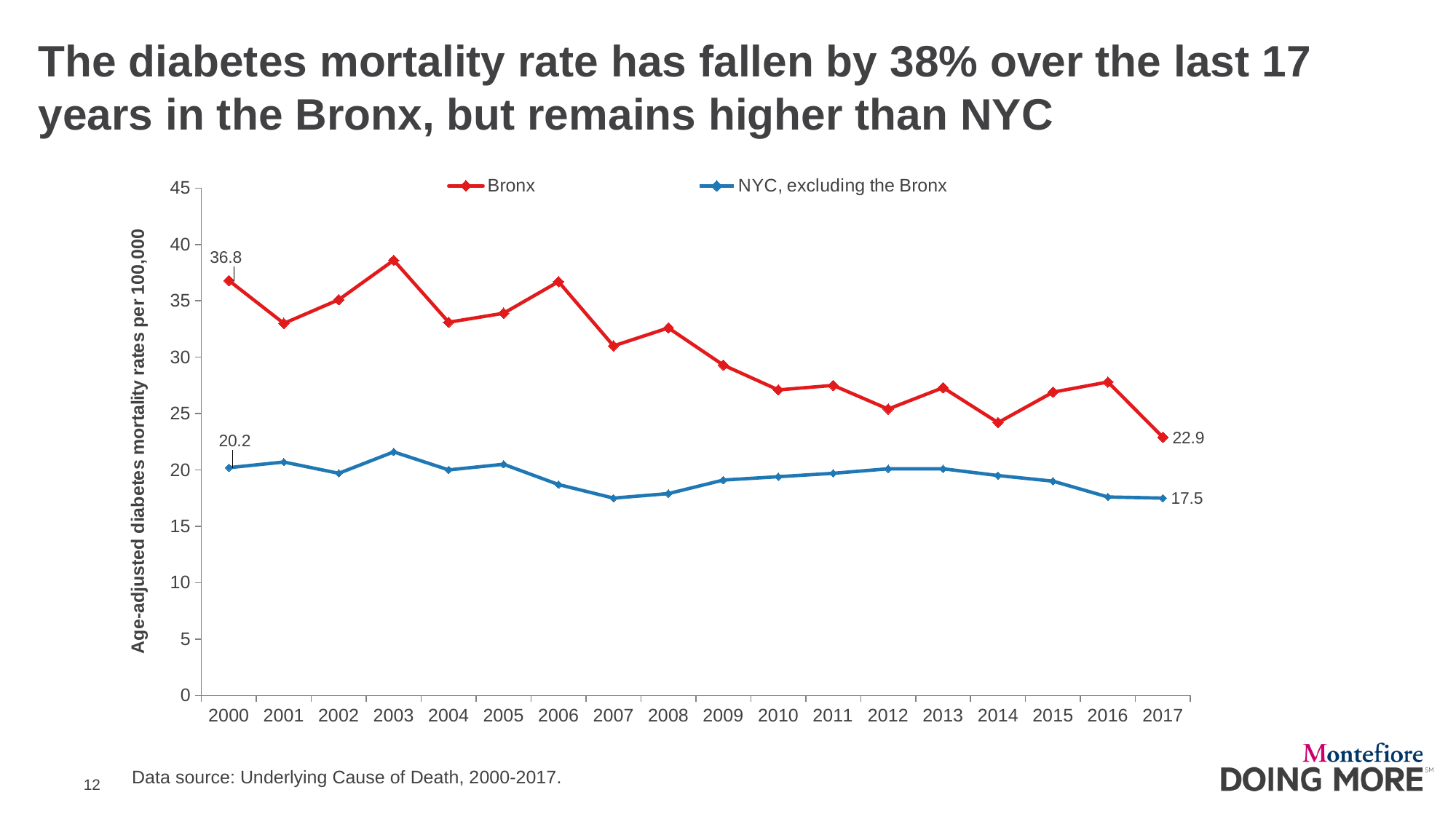
What is the Bronx diabetes mortality rate in 2017? 22.9 Which series has the higher value in 2010, Bronx or NYC, excluding the Bronx? Bronx What is the value for NYC, excluding the Bronx in 2000? 20.2 Is the Bronx value in 2003 greater or less than 35? greater Is the value for NYC, excluding the Bronx in 2007 greater or less than 20? less By how much did the Bronx rate fall between 2000 and 2017? 13.9 Does the Bronx series generally rise or fall from 2000 to 2017? Fall What is the value for NYC, excluding the Bronx in 2017? 17.5 How many series does the legend list? 2 What is the difference between the Bronx and NYC, excluding the Bronx values in 2017? 5.4 What kind of chart is shown on the slide? Line chart What is the Bronx diabetes mortality rate in 2000? 36.8